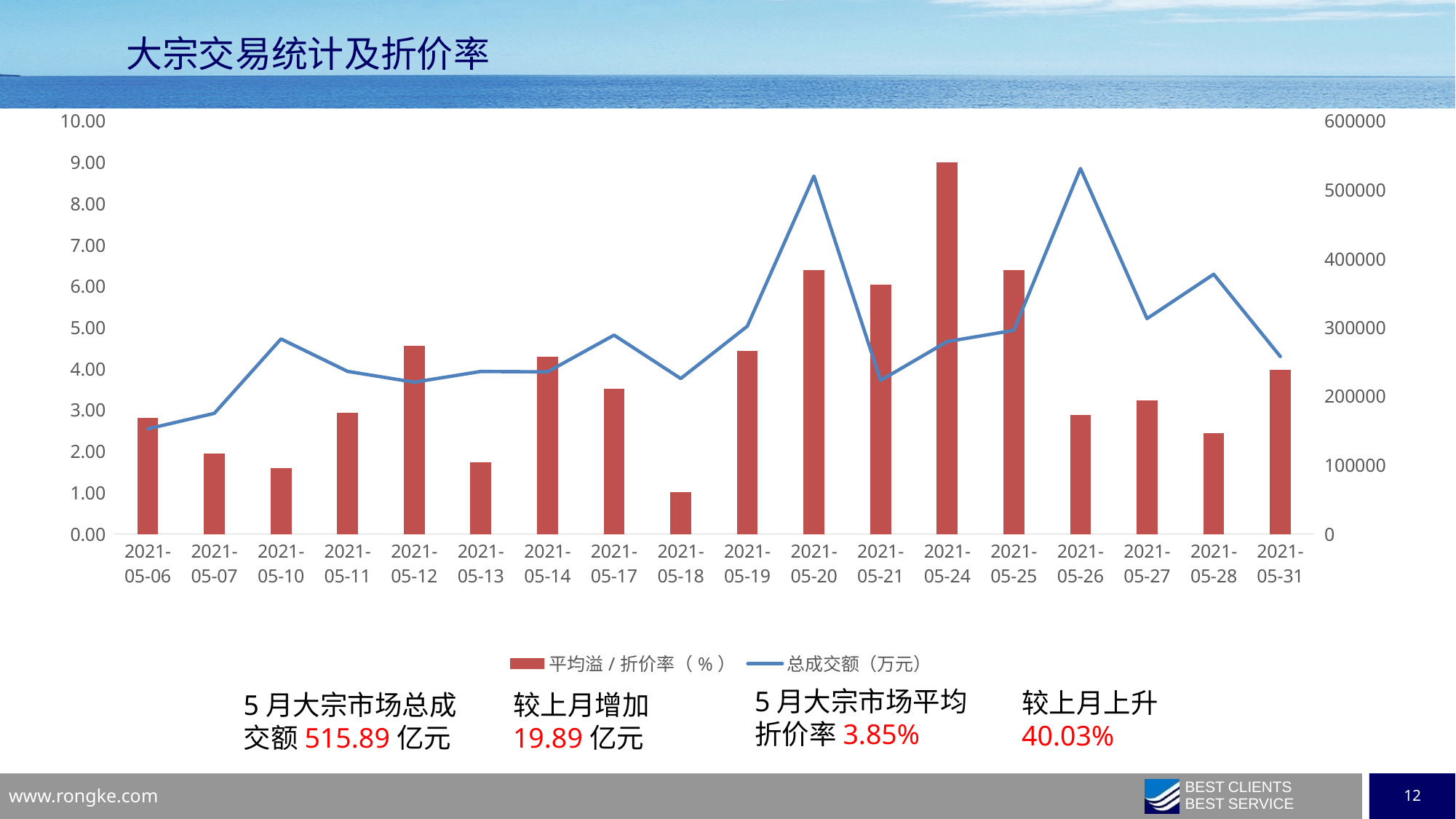
On which date is the 平均溢/折价率 bar the highest? 2021-05-24 On which date is the 总成交额 line at its lowest point? 2021-05-06 Do the 平均溢/折价率 bars rise or fall from 2021-05-18 to 2021-05-24? rise How many series does the legend list? 2 What kind of chart is shown on the slide? A combination bar and line chart On which date is the 平均溢/折价率 bar the lowest? 2021-05-18 Is the 平均溢/折价率 bar for 2021-05-24 greater or less than 8.00? greater Is the 总成交额 value for 2021-05-21 greater or less than 300000? less How many dates are shown on the x axis? 18 Is the 平均溢/折价率 bar for 2021-05-10 greater or less than 2.00? less Which has the larger 平均溢/折价率 bar, 2021-05-12 or 2021-05-13? 2021-05-12